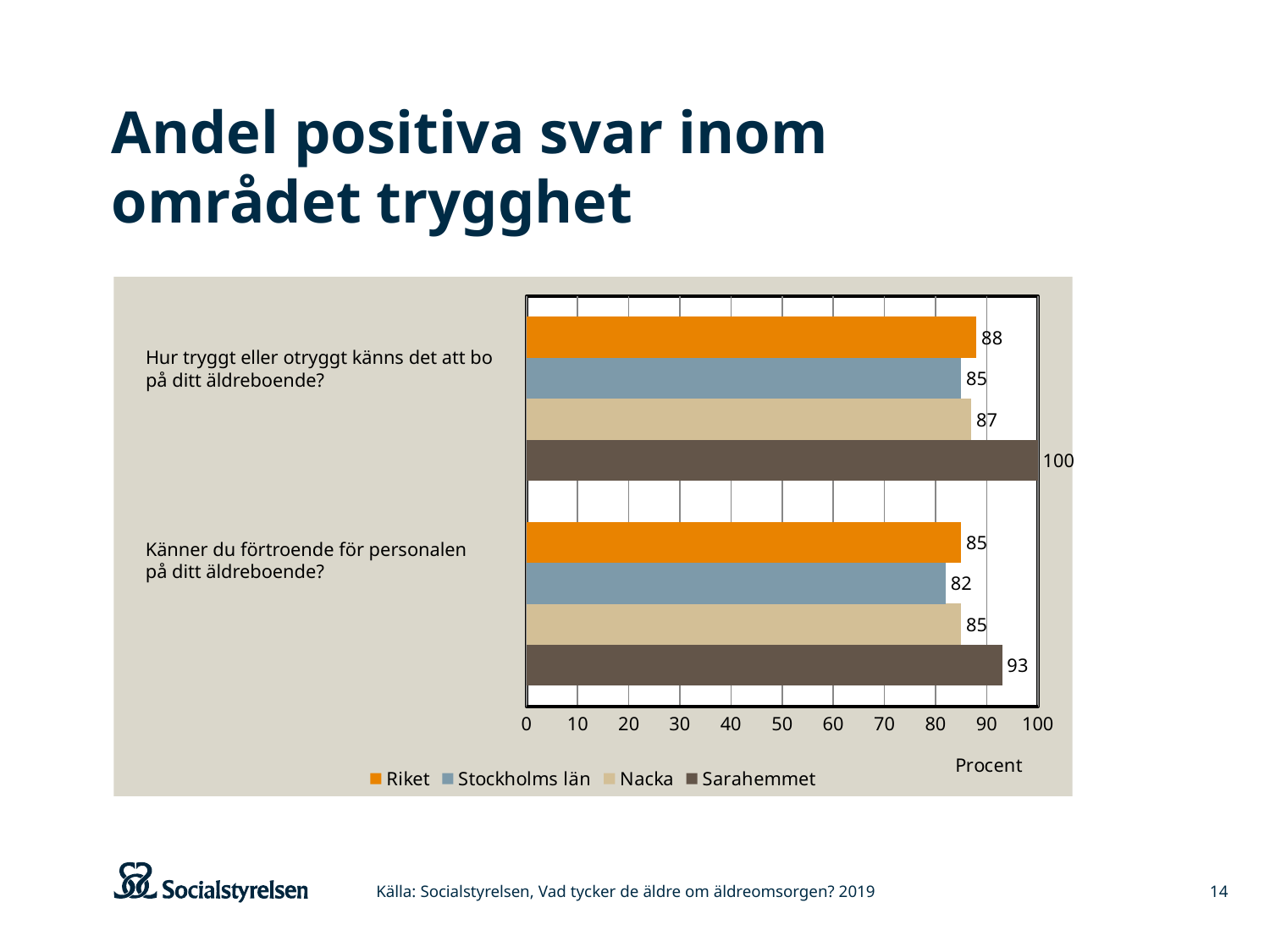
Which series has the highest value for the question "Känner du förtroende för personalen på ditt äldreboende?"? Sarahemmet What is the value for Sarahemmet for the question "Hur tryggt eller otryggt känns det att bo på ditt äldreboende?"? 100 What is the value for Stockholms län for the question "Känner du förtroende för personalen på ditt äldreboende?"? 82 What is the value for Nacka for the question "Känner du förtroende för personalen på ditt äldreboende?"? 85 Which series has the lowest value for the question "Hur tryggt eller otryggt känns det att bo på ditt äldreboende?"? Stockholms län What is the value for Riket for the question "Hur tryggt eller otryggt känns det att bo på ditt äldreboende?"? 88 What kind of chart is shown on the slide? Bar chart What unit is shown on the x axis of the chart? Procent How many series does the legend list? 4 Which is larger: the Riket value for "Hur tryggt eller otryggt känns det att bo på ditt äldreboende?" or the Riket value for "Känner du förtroende för personalen på ditt äldreboende?"? Hur tryggt eller otryggt känns det att bo på ditt äldreboende? What is the difference between the Sarahemmet and Stockholms län values for the question "Känner du förtroende för personalen på ditt äldreboende?"? 11 What is the difference between the Sarahemmet and Riket values for the question "Hur tryggt eller otryggt känns det att bo på ditt äldreboende?"? 12